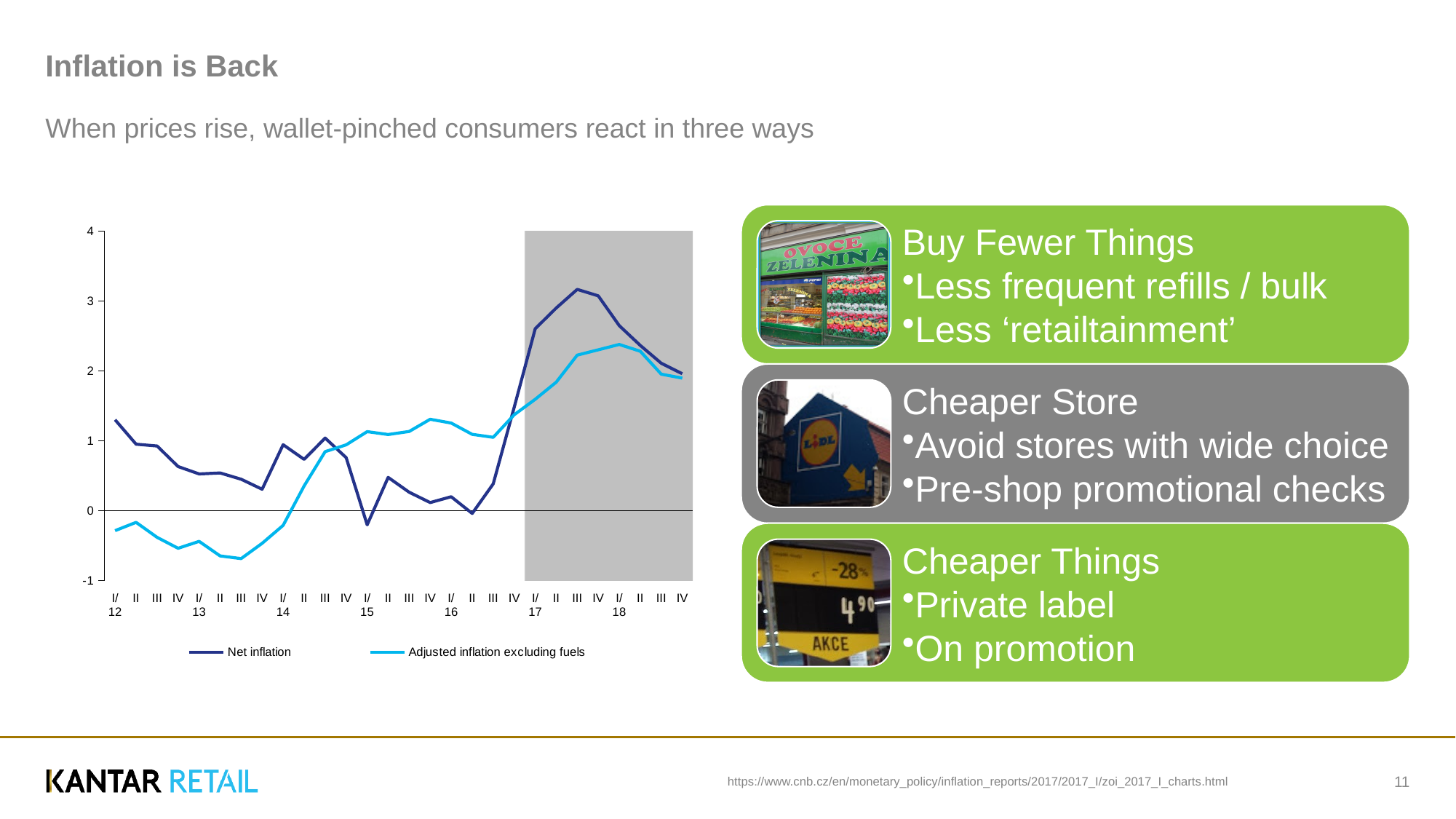
How many series does the chart legend list? 2 Is the value of Net inflation at III/17 greater or less than 3? greater Is the value of Net inflation at I/12 greater or less than 1? greater In which quarter does Adjusted inflation excluding fuels reach its lowest value? III/13 Is the value of Net inflation at I/15 greater or less than 0? less In which quarter does Net inflation reach its highest value? III/17 Does Net inflation rise or fall from III/17 to IV/18? fall How many quarterly points are plotted along the x axis of the chart? 28 What kind of chart is shown on the slide? line chart What are the two series named in the chart legend? Net inflation; Adjusted inflation excluding fuels At I/16, which series has the higher value, Net inflation or Adjusted inflation excluding fuels? Adjusted inflation excluding fuels